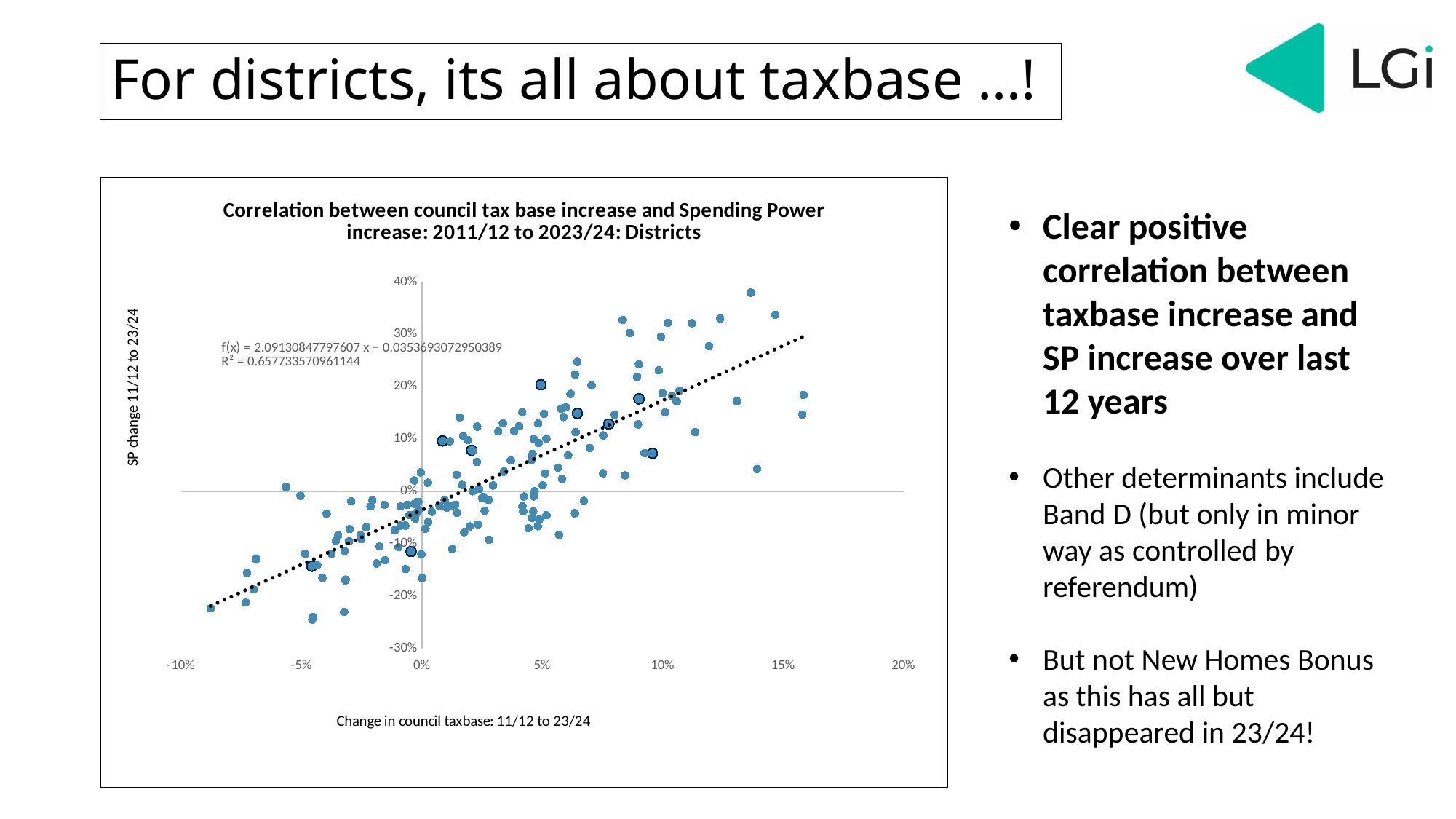
Is the lowest plotted SP change value greater or less than -20%? less What is the highest tick value shown on the x axis? 20% What is the slope coefficient in the trendline equation printed on the chart? 2.09130847797607 What R² value is printed on the chart for the trendline? 0.657733570961144 Do the plotted points generally rise or fall as the change in council taxbase increases along the x axis? rise Is the highest plotted SP change value greater or less than 30%? greater What is the lowest tick value shown on the y axis? -30% What is the highest tick value shown on the y axis? 40% What is the title of the chart? Correlation between council tax base increase and Spending Power increase: 2011/12 to 2023/24: Districts What is the label on the x axis of the chart? Change in council taxbase: 11/12 to 23/24 What kind of chart is shown on the slide? scatter chart